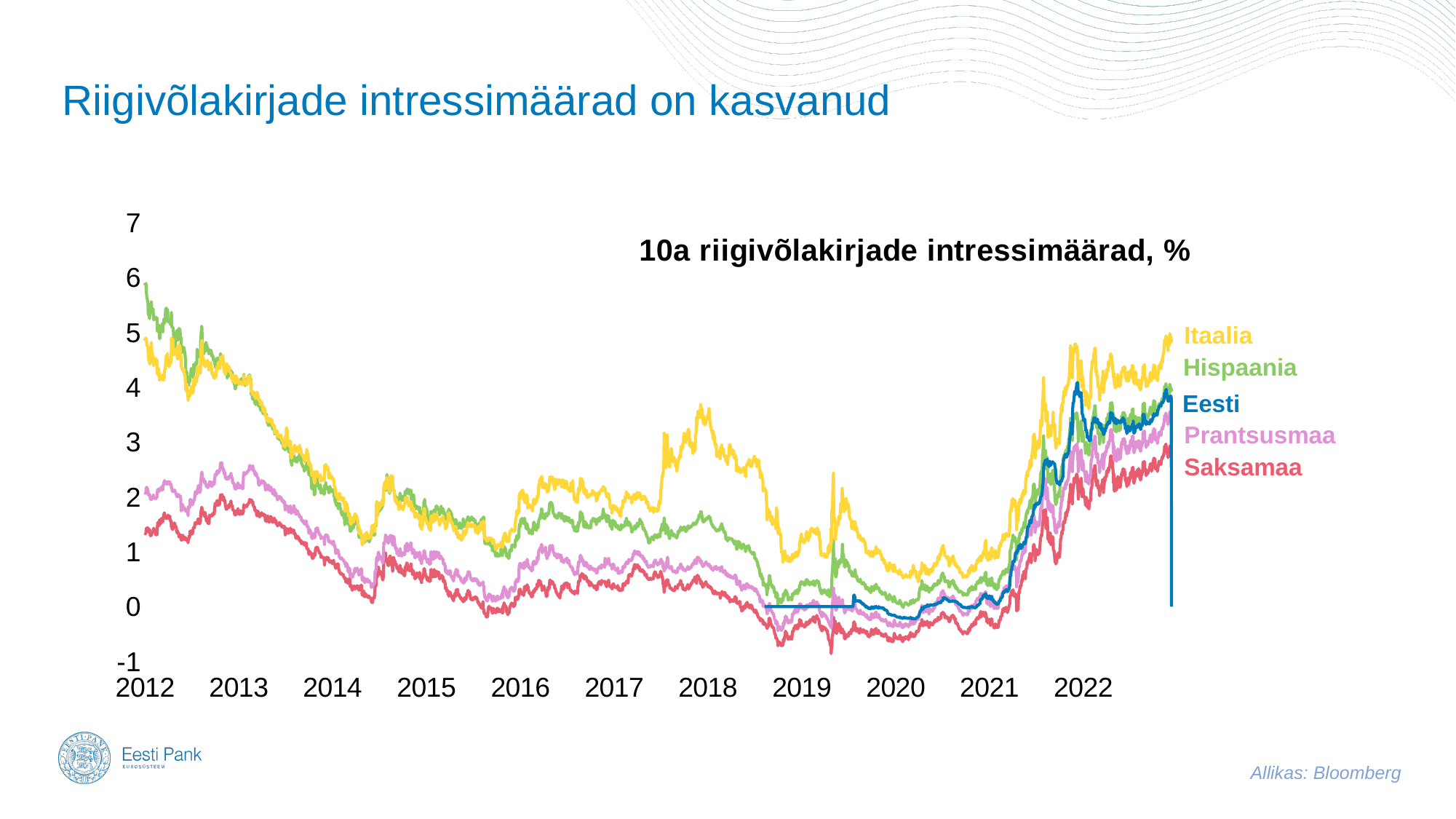
At the start of 2012, is the value for Hispaania greater or less than 5? greater Does the Itaalia line rise or fall from 2012 to 2015? fall What is the title of the chart? 10a riigivõlakirjade intressimäärad, % What source is cited for the chart data? Bloomberg Does the Saksamaa line rise or fall from the start of 2021 to the end of 2022? rise At the end of 2022, is the value for Itaalia greater or less than 4? greater How many series (countries) are plotted in the chart? 5 Which country's line is the lowest at the end of 2022? Saksamaa At the end of 2022, is the value for Saksamaa greater or less than 3? less At the end of 2022, which is larger, the value for Itaalia or the value for Saksamaa? Itaalia What kind of chart is shown on the slide? line chart Which country's line is the highest at the end of 2022? Itaalia